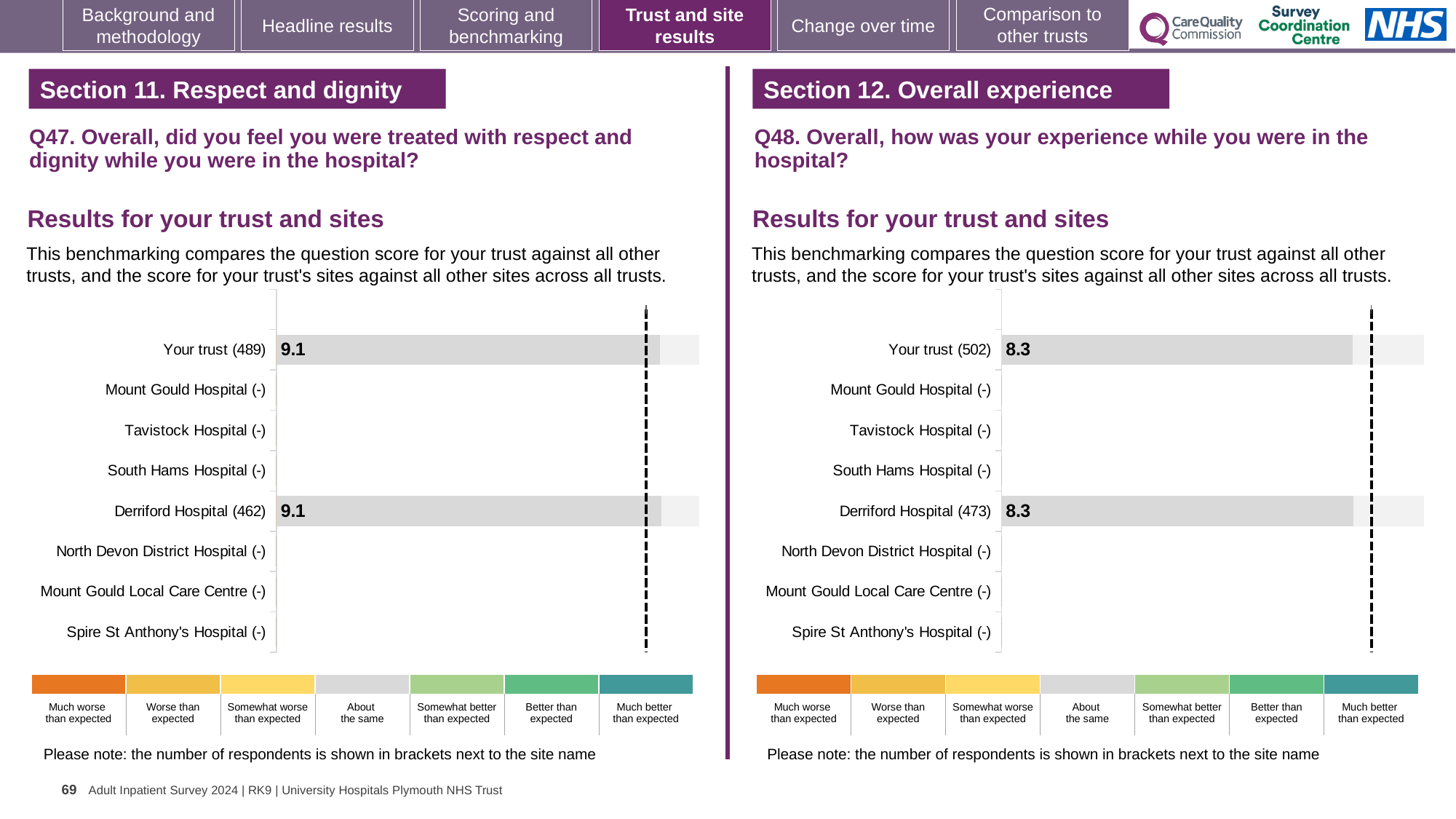
In the Q48 chart on the right, what is the score for Your trust? 8.3 In the Q47 chart on the left, what is the score for Your trust? 9.1 In the Q47 chart on the left, what is the difference between the score for Your trust and the score for Derriford Hospital? 0 In the Q47 chart on the left, how many respondents are shown in brackets for Derriford Hospital? 462 In the Q48 chart on the right, how many site or trust categories are listed on the vertical axis? 8 In the Q48 chart on the right, how many respondents are shown in brackets for Your trust? 502 What kind of chart is used in the Q47 chart on the left? Bar chart In the Q47 chart on the left, what is the score for Derriford Hospital? 9.1 In the Q48 chart on the right, which benchmarking category does the colour of the Derriford Hospital bar correspond to in the legend? About the same In the Q48 chart on the right, what is the score for Derriford Hospital? 8.3 Is the score for Your trust in the Q47 chart on the left larger than the score for Your trust in the Q48 chart on the right? Yes How many benchmarking categories does the colour legend below the Q47 chart on the left list? 7